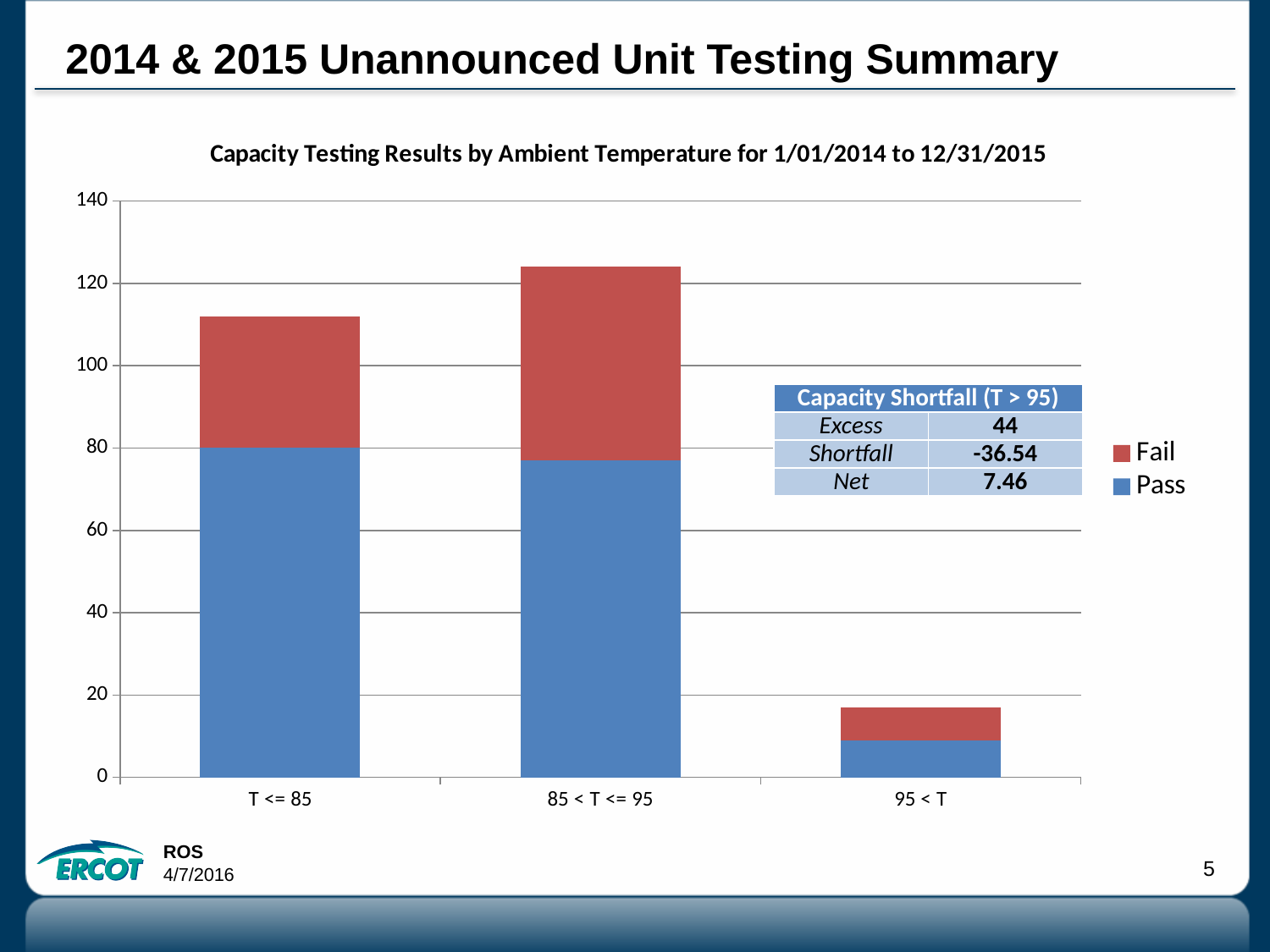
Which colour represents the Fail series in the legend? red Is the total height of the bar for 95 < T greater or less than 20? less How many series does the legend list? 2 Is the total height of the bar for T <= 85 greater or less than 100? greater How many temperature categories are shown on the x axis? 3 Which temperature category has the shortest stacked bar? 95 < T Is the total height of the bar for 85 < T <= 95 greater or less than 100? greater Which has the taller stacked bar, T <= 85 or 95 < T? T <= 85 Which temperature category has the tallest stacked bar? 85 < T <= 95 What is the title of the chart? Capacity Testing Results by Ambient Temperature for 1/01/2014 to 12/31/2015 What kind of chart is shown on the slide? bar chart